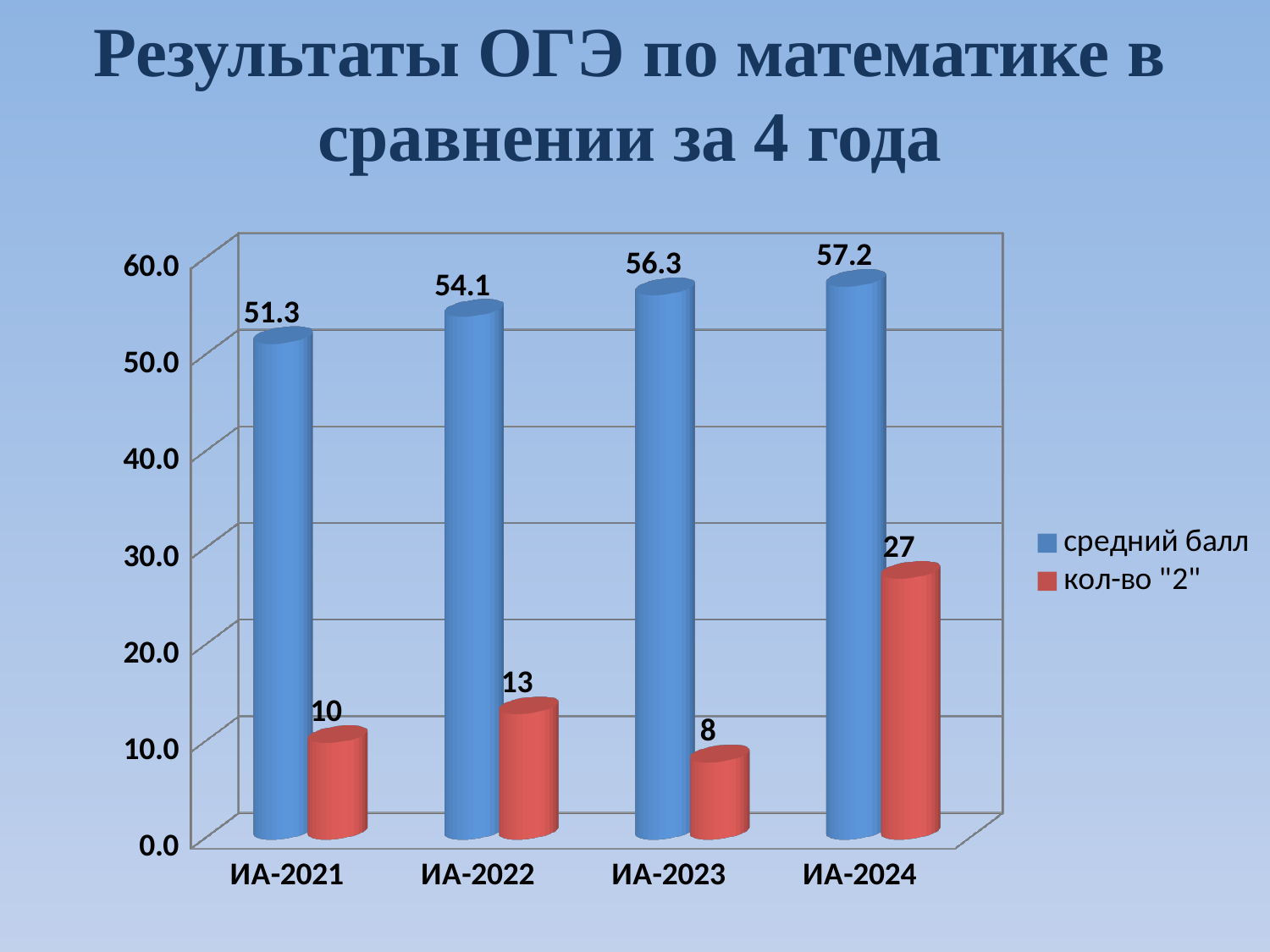
How many series does the legend list? 2 What is the difference between the средний балл for ИА-2024 and ИА-2021? 5.9 What is the средний балл value for ИА-2023? 56.3 Which is larger, the кол-во "2" for ИА-2021 or for ИА-2022? ИА-2022 What is the средний балл value for ИА-2021? 51.3 Does the средний балл rise or fall from ИА-2021 to ИА-2024? rise Which year has the lowest кол-во "2"? ИА-2023 Which year has the highest средний балл? ИА-2024 What is the кол-во "2" value for ИА-2024? 27 How many years (categories) are shown on the x axis? 4 What is the difference between the кол-во "2" for ИА-2024 and ИА-2022? 14 What kind of chart is shown on the slide? bar chart